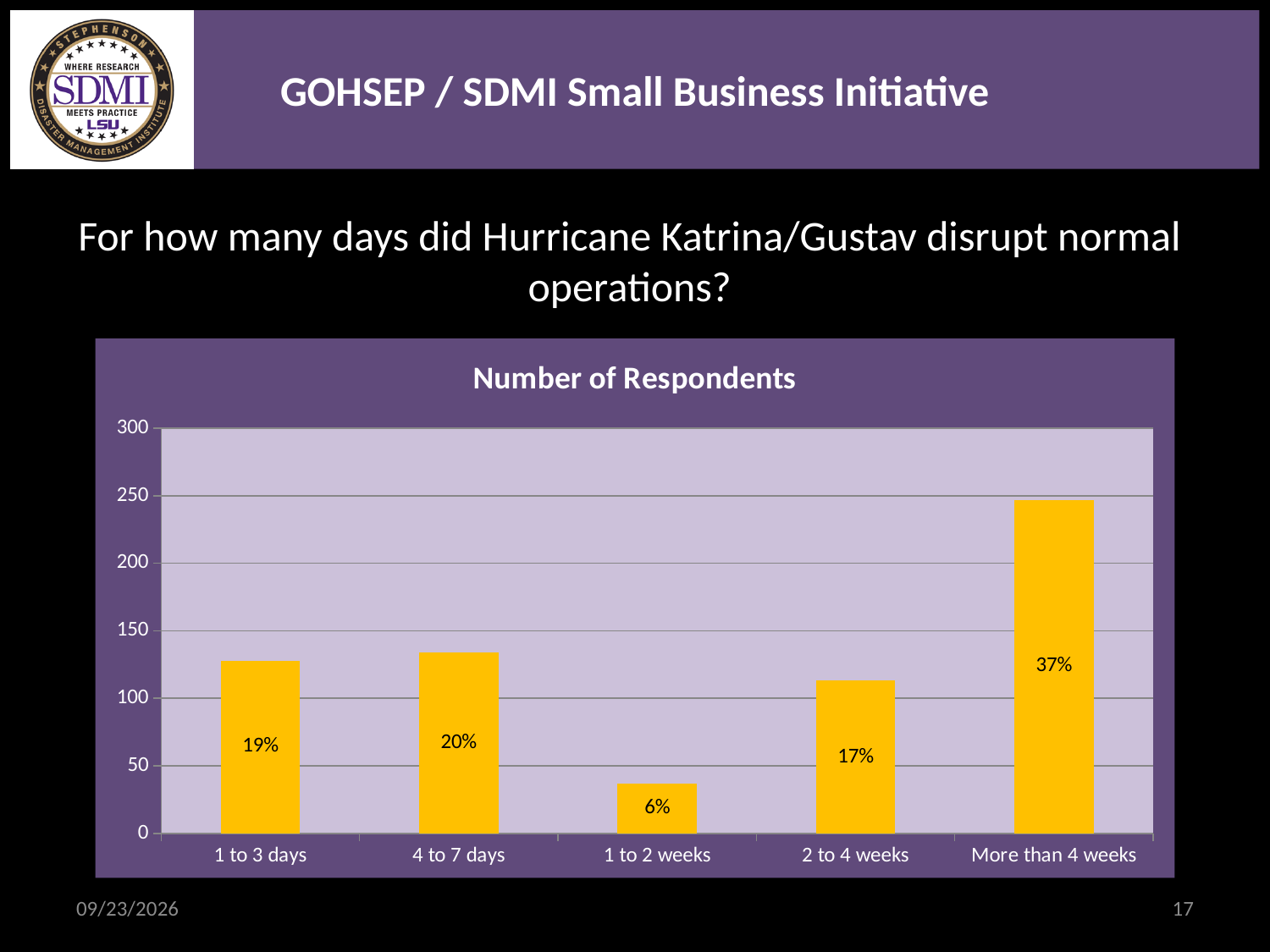
What percentage label is shown on the bar for "1 to 3 days"? 19% Is the number of respondents for "4 to 7 days" greater or less than 150? less What percentage label is shown on the bar for "More than 4 weeks"? 37% Which category has the tallest bar? More than 4 weeks What percentage label is shown on the bar for "2 to 4 weeks"? 17% Which bar is taller: "2 to 4 weeks" or "More than 4 weeks"? More than 4 weeks What type of chart is shown on the slide? Bar chart Is the number of respondents for "1 to 2 weeks" greater or less than 50? less Is the number of respondents for "More than 4 weeks" greater or less than 200? greater How many categories are shown on the x axis? 5 Which category has the shortest bar? 1 to 2 weeks What percentage label is shown on the bar for "1 to 2 weeks"? 6%